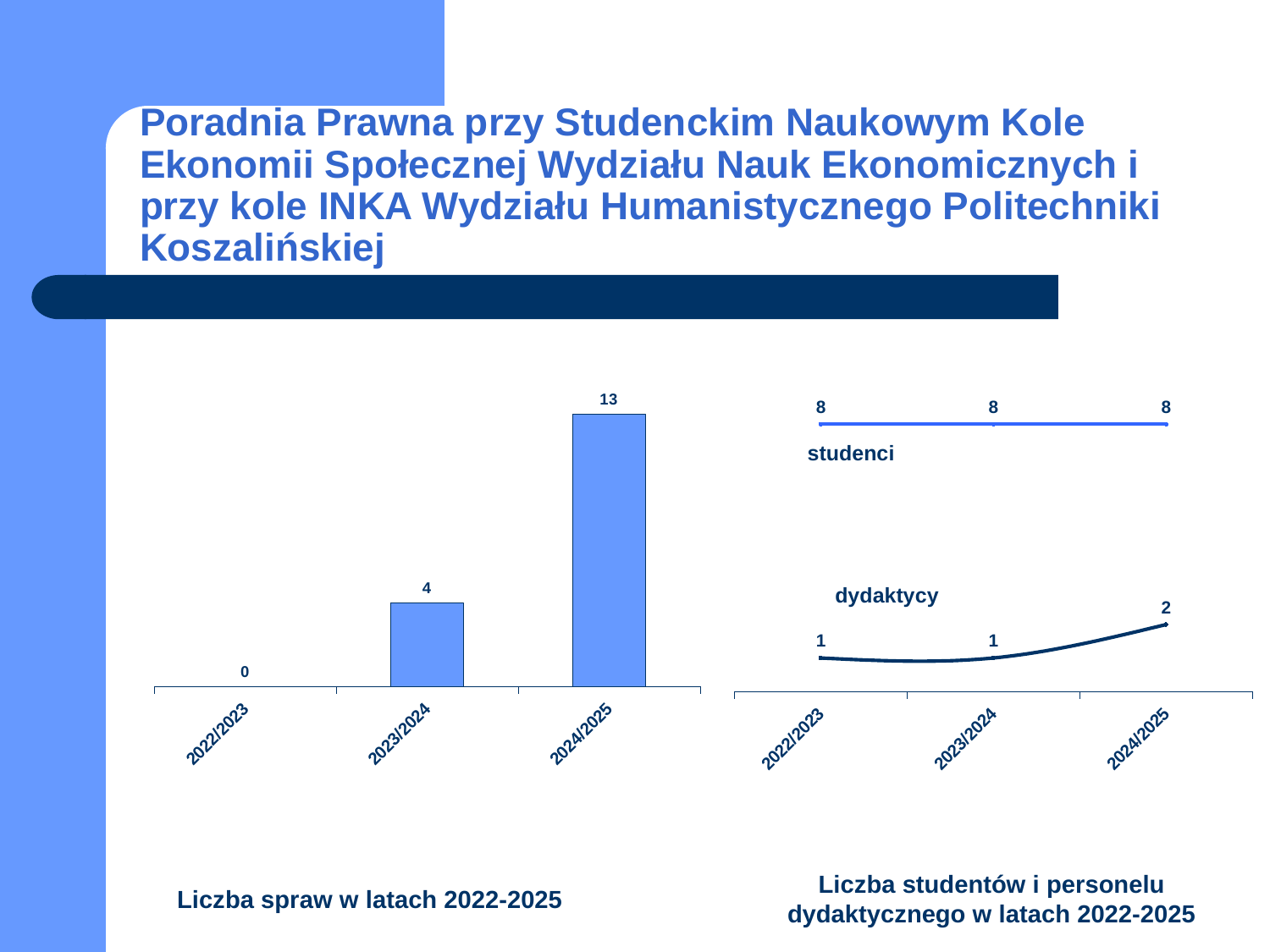
In the right chart (Liczba studentów i personelu dydaktycznego w latach 2022-2025), what is the value for dydaktycy in 2024/2025? 2 In the left chart (Liczba spraw w latach 2022-2025), what is the value for 2023/2024? 4 What kind of chart is the left chart (Liczba spraw w latach 2022-2025)? bar chart In the left chart (Liczba spraw w latach 2022-2025), which year has the highest value? 2024/2025 In the right chart (Liczba studentów i personelu dydaktycznego w latach 2022-2025), what is the value for studenci in 2023/2024? 8 In the left chart (Liczba spraw w latach 2022-2025), what is the difference between the values for 2024/2025 and 2023/2024? 9 In the left chart (Liczba spraw w latach 2022-2025), what is the value for 2024/2025? 13 In the right chart (Liczba studentów i personelu dydaktycznego w latach 2022-2025), which is larger in 2022/2023: studenci or dydaktycy? studenci In the left chart (Liczba spraw w latach 2022-2025), do the values rise or fall from 2022/2023 to 2024/2025? rise What kind of chart is the right chart (Liczba studentów i personelu dydaktycznego w latach 2022-2025)? line chart In the left chart (Liczba spraw w latach 2022-2025), which year has the lowest value? 2022/2023 In the left chart (Liczba spraw w latach 2022-2025), how many categories are shown on the x axis? 3